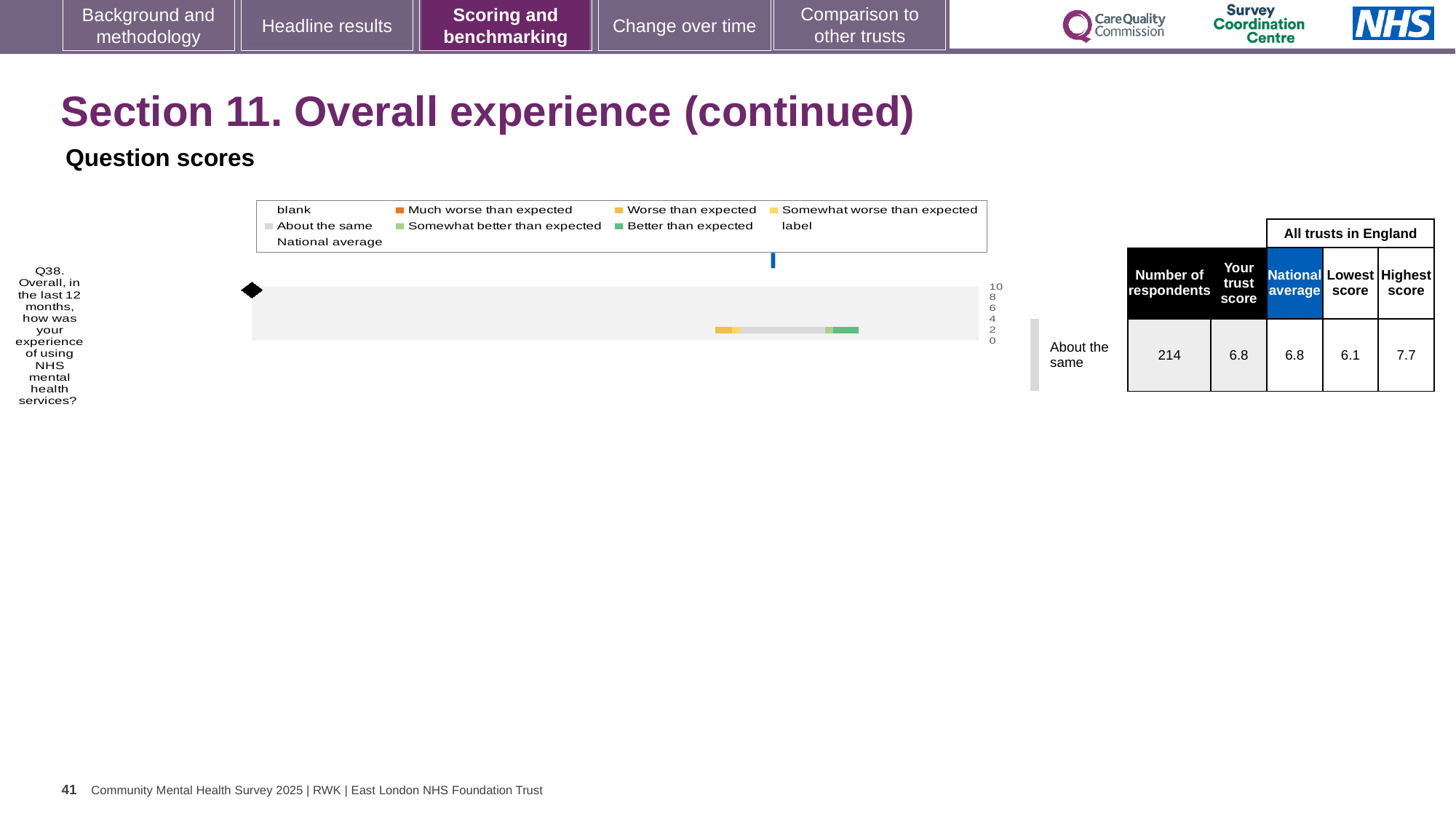
What benchmark category is the trust's Q38 score placed in? About the same Which question is plotted on the chart? Q38. Overall, in the last 12 months, how was your experience of using NHS mental health services? What is the national average score for Q38? 6.8 What is the lowest score among all trusts in England for Q38? 6.1 What is the trust's score for Q38? 6.8 How much higher is the highest score in England than the trust's score for Q38? 0.9 How many respondents answered Q38? 214 What is the difference between the highest and lowest trust scores for Q38? 1.6 How many survey questions are plotted on the chart? 1 What is the maximum value shown on the chart's score axis? 10 What is the highest score among all trusts in England for Q38? 7.7 What type of chart is used to show the Q38 question score? bar chart